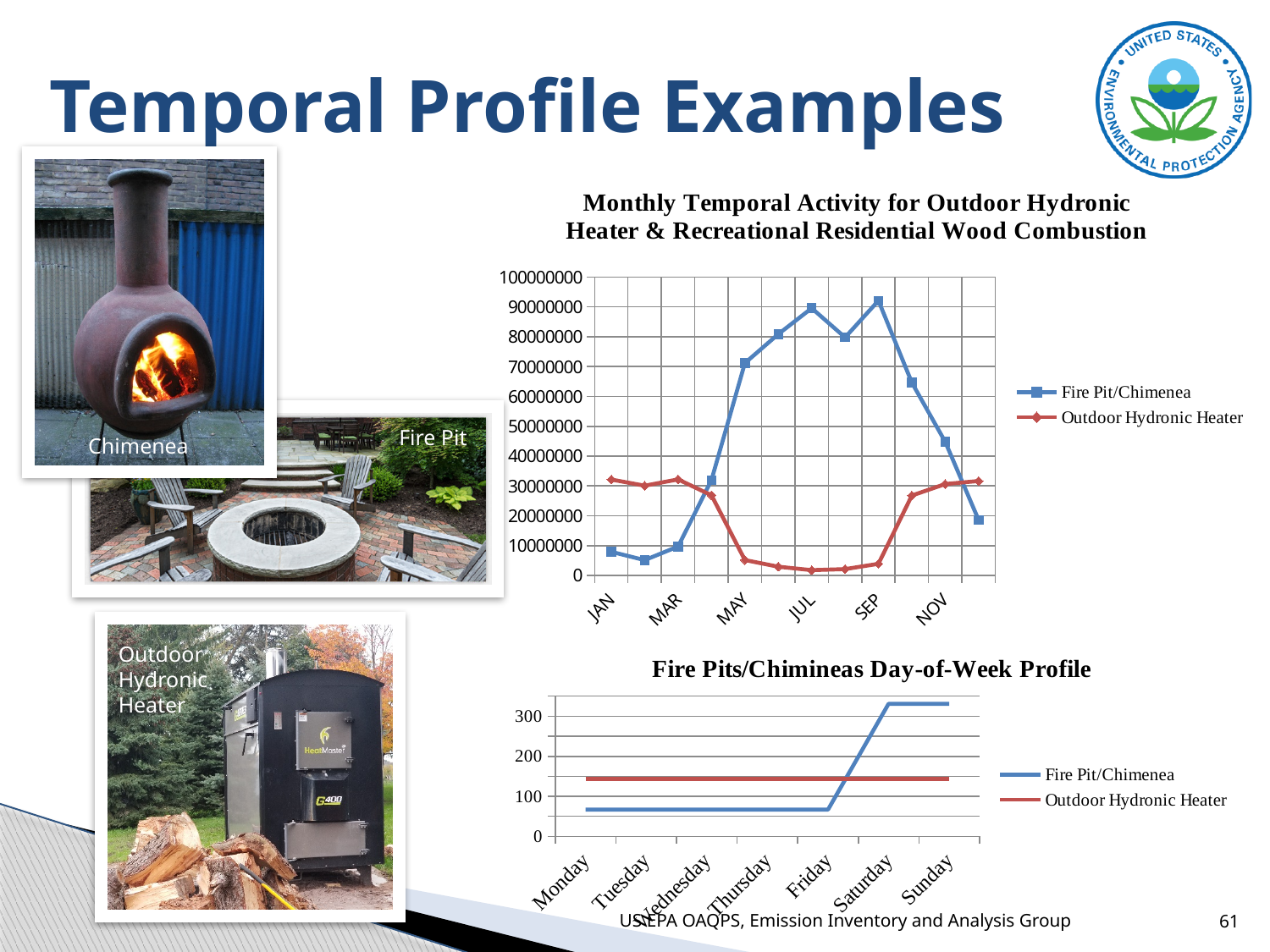
How many days are shown on the x axis of the 'Fire Pits/Chimineas Day-of-Week Profile' chart? 7 In the 'Monthly Temporal Activity' chart, does the Fire Pit/Chimenea series rise or fall from MAR to JUL? rise What kind of chart is the 'Fire Pits/Chimineas Day-of-Week Profile' chart? line chart In the 'Monthly Temporal Activity' chart, which series has the larger value in JAN, Fire Pit/Chimenea or Outdoor Hydronic Heater? Outdoor Hydronic Heater What kind of chart is the 'Monthly Temporal Activity for Outdoor Hydronic Heater & Recreational Residential Wood Combustion' chart? line chart In the 'Fire Pits/Chimineas Day-of-Week Profile' chart, is the Fire Pit/Chimenea value for Monday greater or less than 100? less In the 'Monthly Temporal Activity' chart, is the Outdoor Hydronic Heater value for JUL greater or less than 10000000? less In the 'Monthly Temporal Activity' chart, which series is drawn in red? Outdoor Hydronic Heater In the 'Fire Pits/Chimineas Day-of-Week Profile' chart, is the Fire Pit/Chimenea value for Saturday greater or less than 300? greater In the 'Fire Pits/Chimineas Day-of-Week Profile' chart, which series has the larger value on Sunday, Fire Pit/Chimenea or Outdoor Hydronic Heater? Fire Pit/Chimenea How many series does the legend of the 'Monthly Temporal Activity' chart list? 2